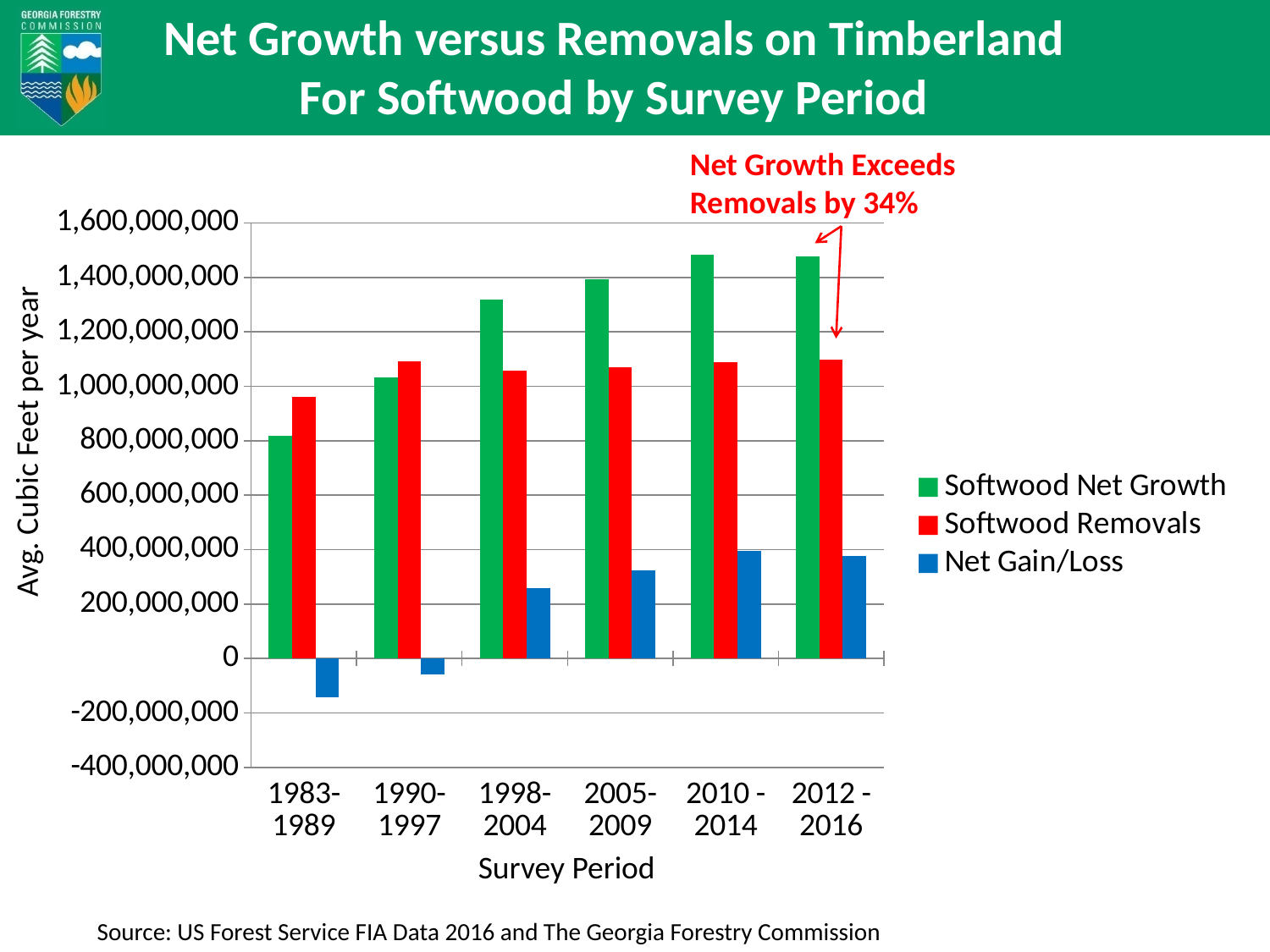
By what percentage does the annotation say Net Growth exceeds Removals? 34% Is the Softwood Net Growth value for 1983-1989 greater or less than 1,000,000,000? less In the 2012 - 2016 survey period, which is larger: Softwood Net Growth or Softwood Removals? Softwood Net Growth How many survey periods are shown on the x axis? 6 Which survey period has the lowest Softwood Removals? 1983-1989 Does Softwood Net Growth generally rise or fall across the survey periods from 1983-1989 to 2012 - 2016? rise In the 1983-1989 survey period, which is larger: Softwood Net Growth or Softwood Removals? Softwood Removals Which survey period has the lowest Net Gain/Loss? 1983-1989 Which survey period has the lowest Softwood Net Growth? 1983-1989 Is the Softwood Net Growth value for 2012 - 2016 greater or less than 1,400,000,000? greater What kind of chart is shown on the slide? bar chart How many series does the legend list? 3